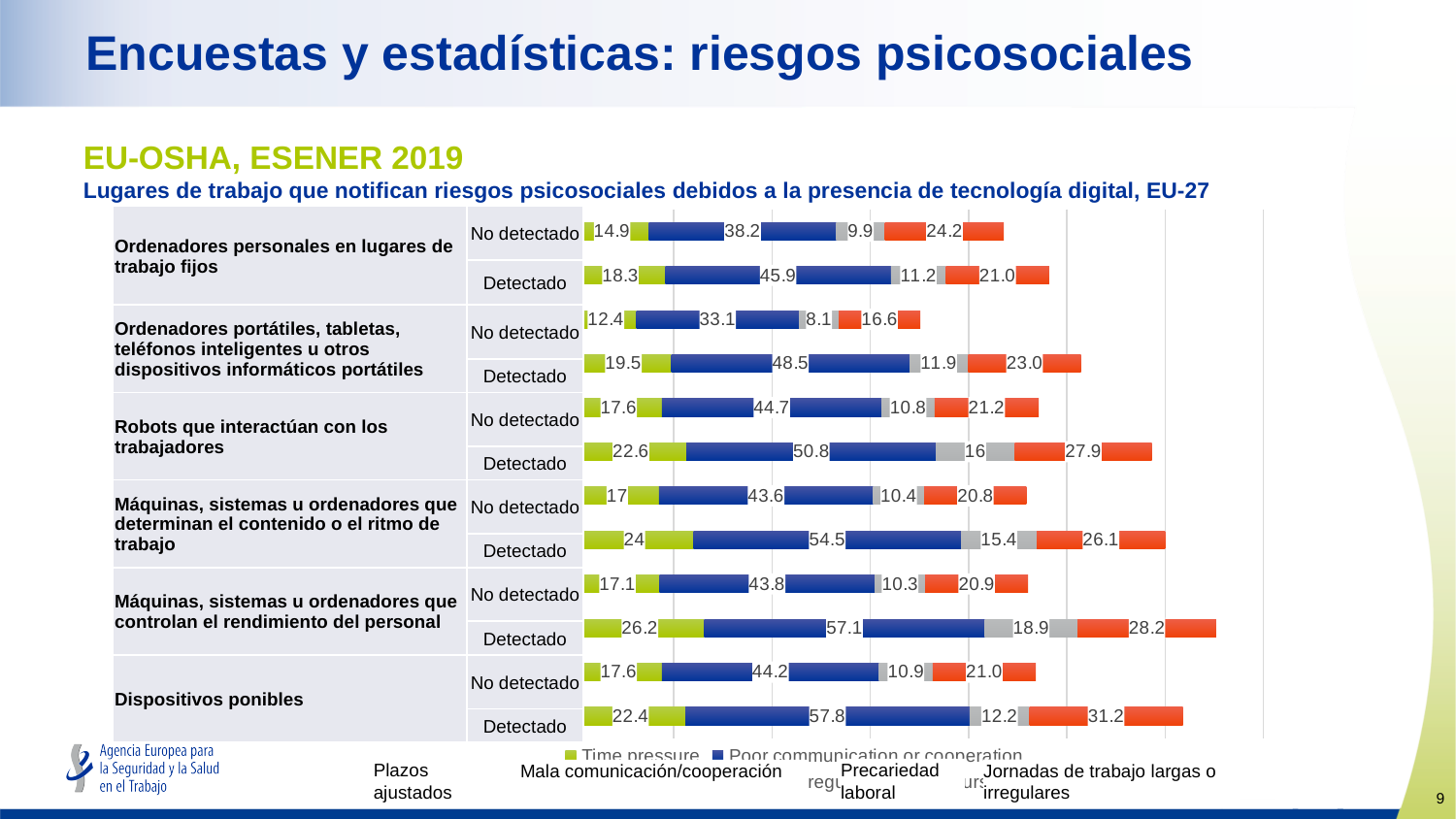
What colour represents Plazos ajustados in the chart? Green Which bar has the highest value for Jornadas de trabajo largas o irregulares? Dispositivos ponibles, Detectado (31.2) What is the total of the No detectado bar for Ordenadores portátiles, tabletas, teléfonos inteligentes u otros dispositivos informáticos portátiles? 70.2 How many series does the chart show? 4 For Ordenadores personales en lugares de trabajo fijos, what is the difference in Mala comunicación/cooperación between the Detectado and No detectado bars? 7.7 What is the Plazos ajustados value in the No detectado bar for Ordenadores portátiles, tabletas, teléfonos inteligentes u otros dispositivos informáticos portátiles? 12.4 Which bar has the lowest value for Precariedad laboral? Ordenadores portátiles, No detectado (8.1) For Ordenadores personales en lugares de trabajo fijos, which bar has the larger Jornadas de trabajo largas o irregulares value, Detectado or No detectado? No detectado What is the Precariedad laboral value in the Detectado bar for Robots que interactúan con los trabajadores? 16 What is the value for Mala comunicación/cooperación in the Detectado bar for Dispositivos ponibles? 57.8 How many bars are plotted in the chart? 12 What kind of chart is shown on the slide? Stacked horizontal bar chart